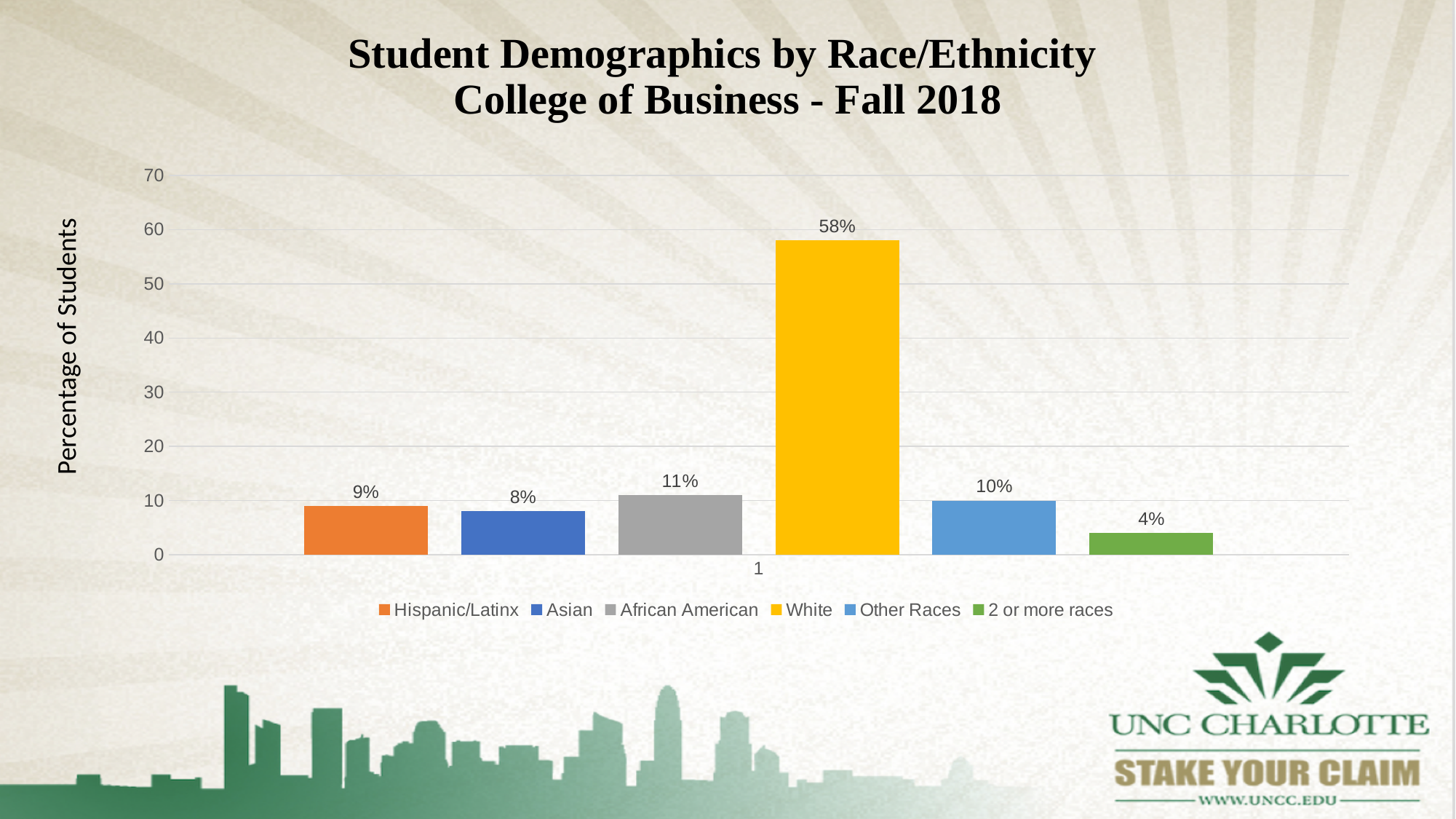
What percentage of students are White? 58% What is the label of the vertical axis? Percentage of Students Which race/ethnicity group has the lowest percentage of students? 2 or more races What percentage of students are African American? 11% How many race/ethnicity groups are shown in the chart? 6 Which is larger, the percentage for Asian students or for Other Races? Other Races What is the difference in percentage points between White and African American students? 47 Which race/ethnicity group has the highest percentage of students? White What percentage of students are Hispanic/Latinx? 9% What percentage of students are 2 or more races? 4% Is the value for White greater or less than 50? greater What type of chart is shown on the slide? Bar chart